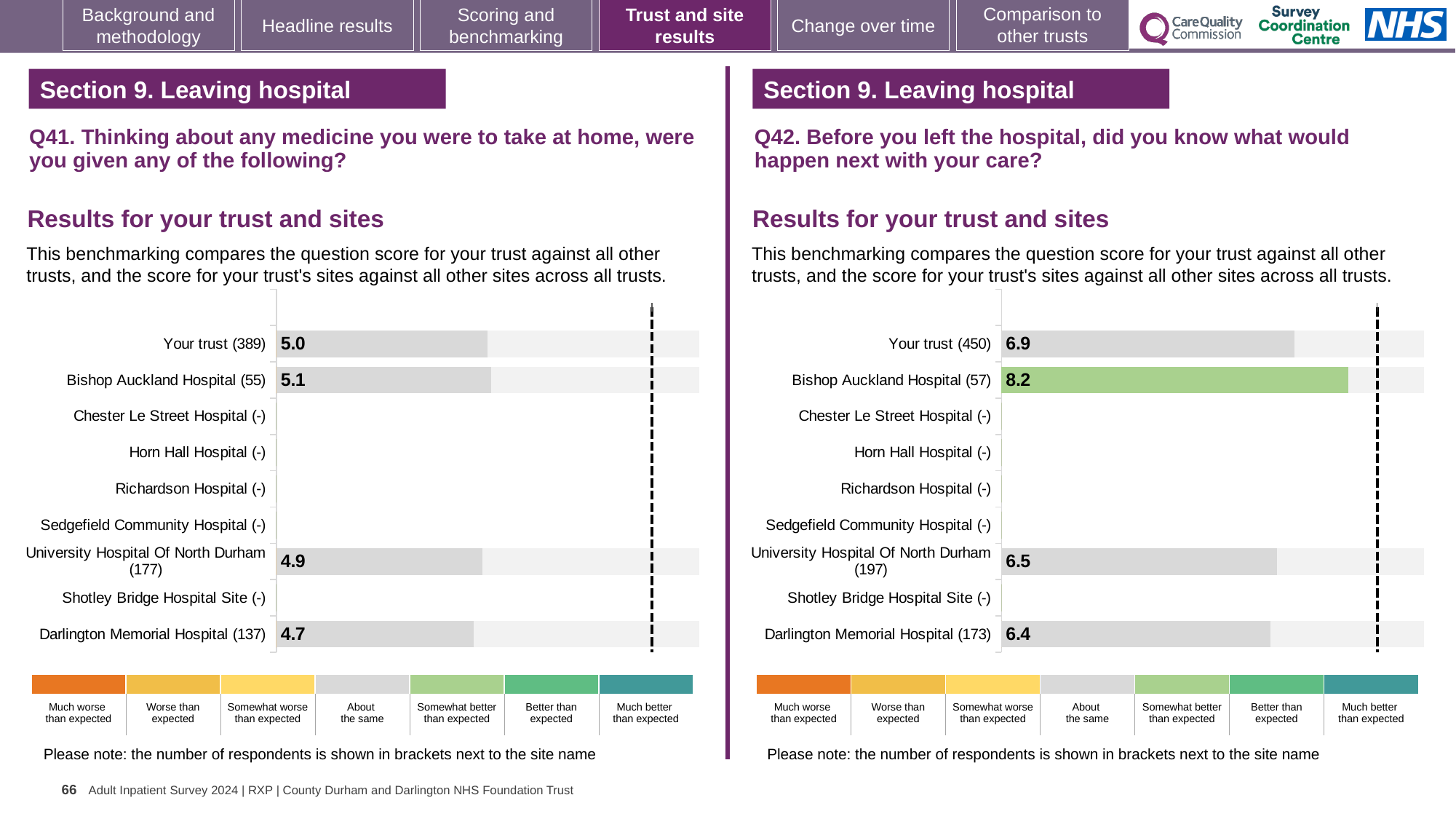
In the Q42 chart on the right, which is larger: the score for Your trust or the score for Darlington Memorial Hospital? Your trust In the Q41 chart on the left, what is the score for Your trust (389)? 5.0 How many site rows (including Your trust) are listed in the Q41 chart on the left? 9 In the Q42 chart on the right, which site's bar is coloured green (somewhat better than expected)? Bishop Auckland Hospital (57) What kind of chart is used in the Q42 chart on the right? Bar chart In the Q42 chart on the right, what is the difference between the scores for Bishop Auckland Hospital and Your trust? 1.3 In the Q41 chart on the left, what is the difference between the scores for Bishop Auckland Hospital and Darlington Memorial Hospital? 0.4 In the Q42 chart on the right, what is the score for Bishop Auckland Hospital (57)? 8.2 In the Q41 chart on the left, which site has the highest score? Bishop Auckland Hospital (55) In the Q42 chart on the right, what is the score for University Hospital Of North Durham (197)? 6.5 In the Q42 chart on the right, which site has the lowest score? Darlington Memorial Hospital (173) In the Q41 chart on the left, what is the score for Darlington Memorial Hospital (137)? 4.7